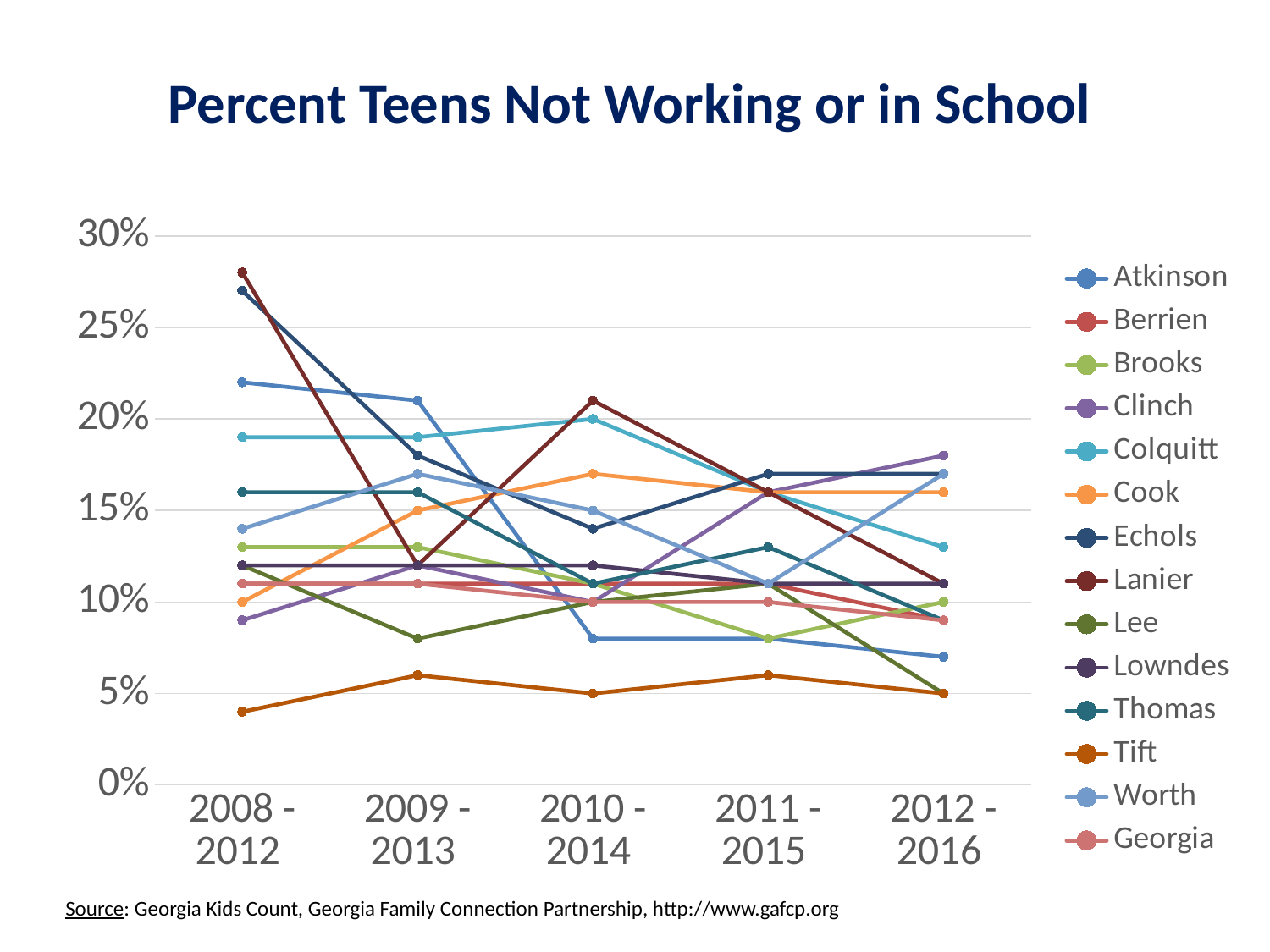
Which series has the lowest value in 2008 - 2012? Tift What is the title of the chart? Percent Teens Not Working or in School How many series does the legend list? 14 Is the value for Atkinson in 2012 - 2016 greater or less than 10%? less Does the value for Atkinson rise or fall from 2008 - 2012 to 2012 - 2016? fall Which is larger in 2008 - 2012, the value for Echols or the value for Worth? Echols Is the value for Atkinson in 2008 - 2012 greater or less than 20%? greater What kind of chart is shown on the slide? line chart Is the value for Echols in 2012 - 2016 greater or less than 15%? greater How many time periods are shown on the x axis? 5 Which series is listed last in the legend? Georgia